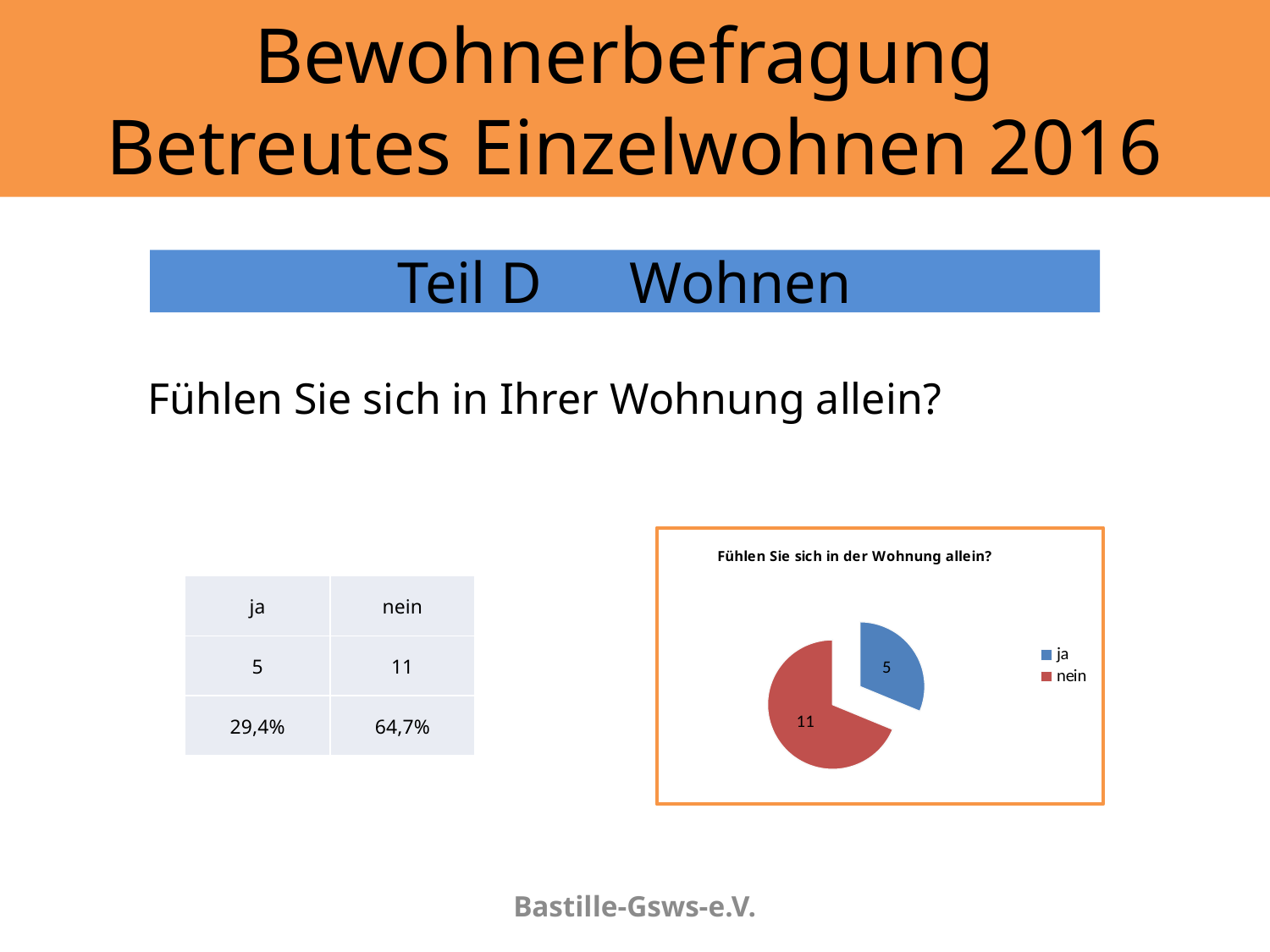
What colour is the "nein" slice in the pie chart? red What is the value of the "nein" slice in the pie chart? 11 Which is larger in the pie chart, "ja" or "nein"? nein What is the total of the values shown in the pie chart? 16 How many entries does the legend of the pie chart list? 2 Which slice of the pie chart is the largest? nein Which slice of the pie chart is the smallest? ja How many slices does the pie chart have? 2 What is the difference between the "nein" and "ja" values in the pie chart? 6 What is the title of the pie chart? Fühlen Sie sich in der Wohnung allein? What kind of chart is shown on the slide? pie chart What is the value of the "ja" slice in the pie chart? 5